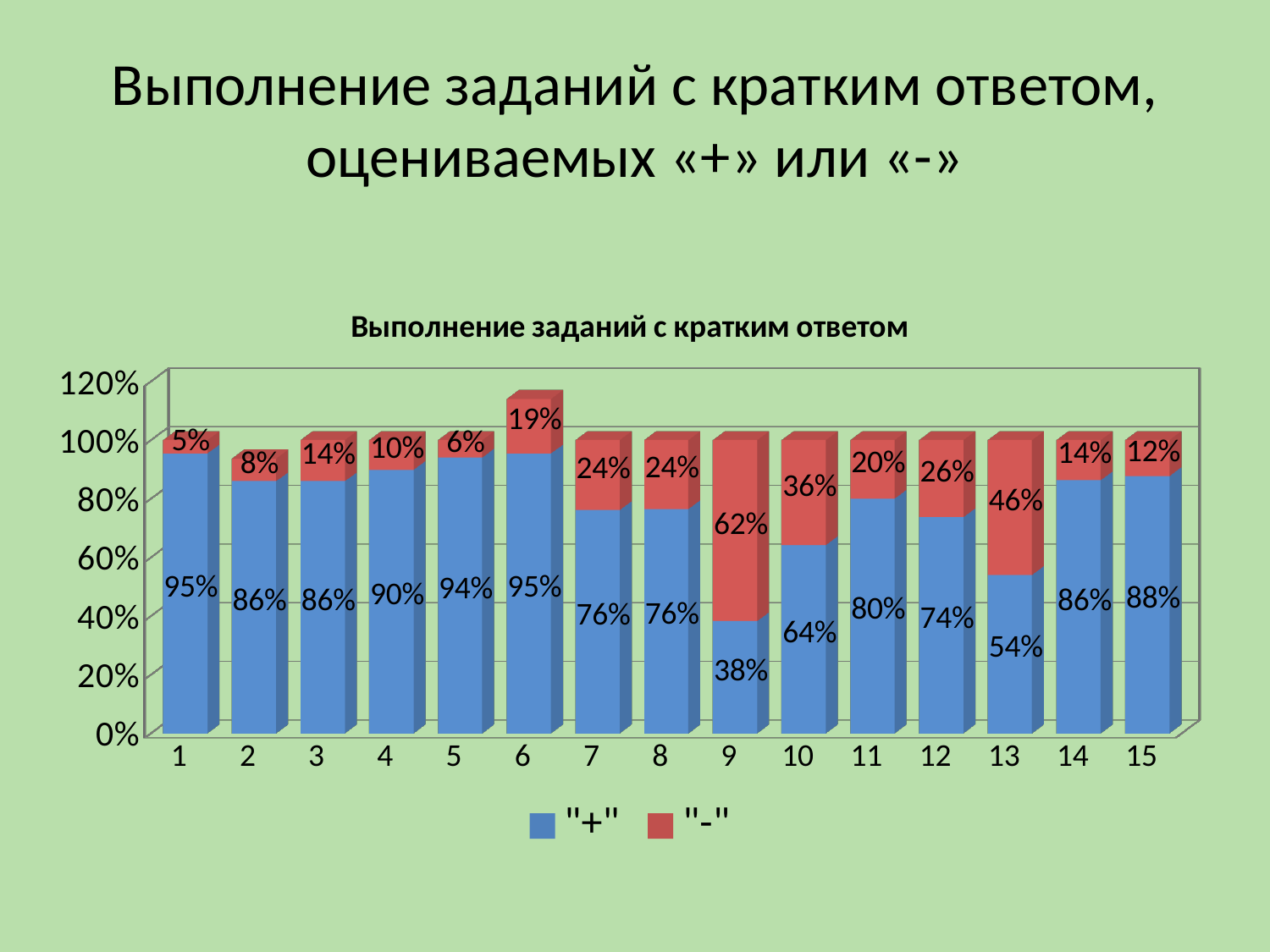
Which category has the highest "-" value? 9 How many categories are shown on the x axis of the chart? 15 What is the total of the stacked bar for category 6? 114% Which category has the lowest "-" value? 1 What kind of chart is shown on the slide? stacked bar chart Which category has the lowest "+" value? 9 How many series does the legend list? 2 What is the "-" value for category 13? 46% What is the "+" value for category 9? 38% What is the difference between the "+" values for category 11 and category 10? 16% What is the "+" value for category 12? 74% Which is larger, the "+" value for category 4 or for category 15? category 4